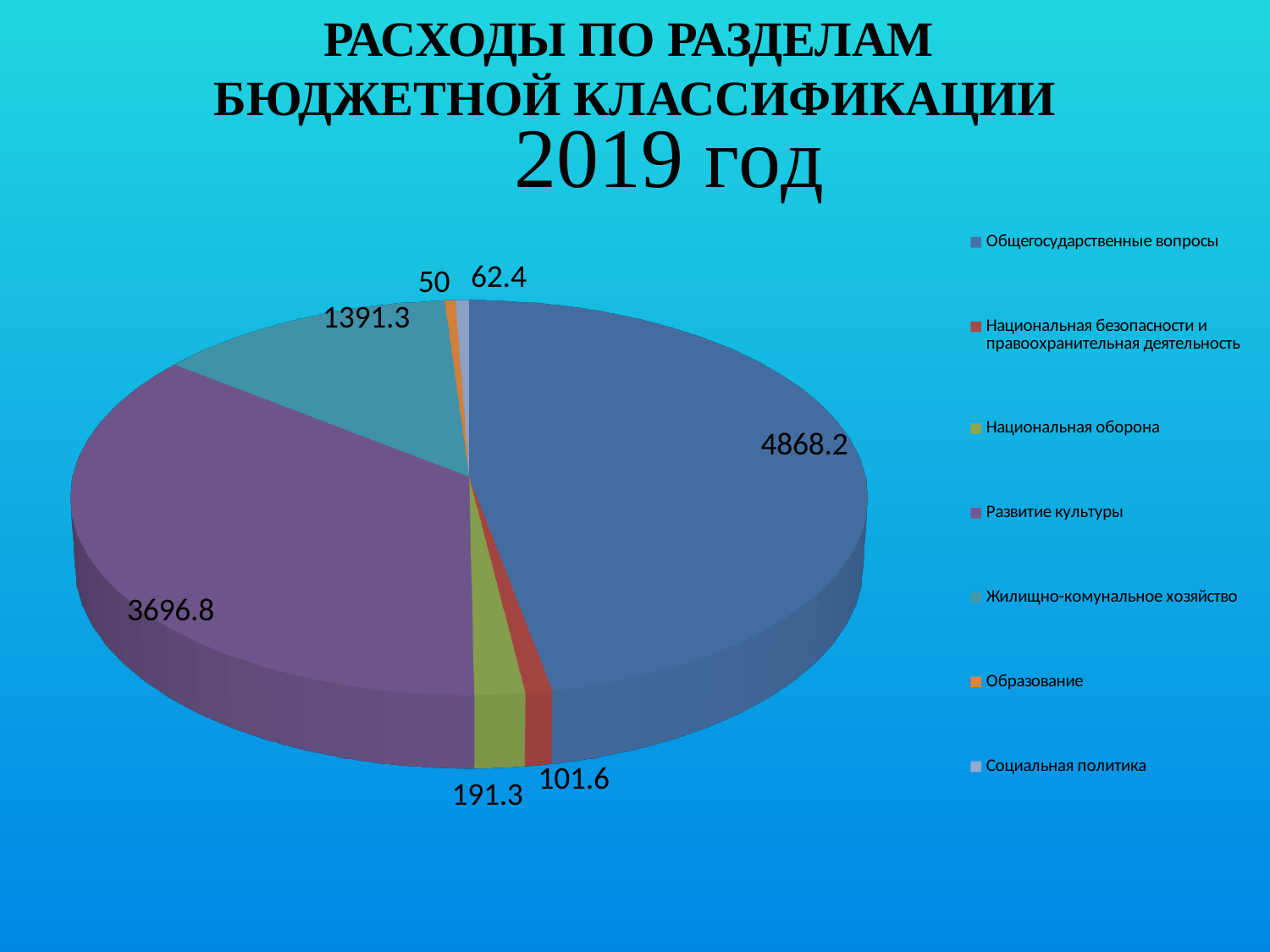
Which category has the smallest slice of the pie? Образование What is the value for Национальная оборона? 191.3 What year is shown in the chart title? 2019 How many categories does the legend list? 7 Which category has the largest slice of the pie? Общегосударственные вопросы What is the value for Развитие культуры? 3696.8 What is the value for Общегосударственные вопросы? 4868.2 What is the value for Образование? 50 What is the value for Жилищно-коммунальное хозяйство? 1391.3 Which is larger, the value for Национальная оборона or the value for Социальная политика? Национальная оборона What kind of chart is shown on the slide? pie chart What is the difference between the values for Общегосударственные вопросы and Развитие культуры? 1171.4